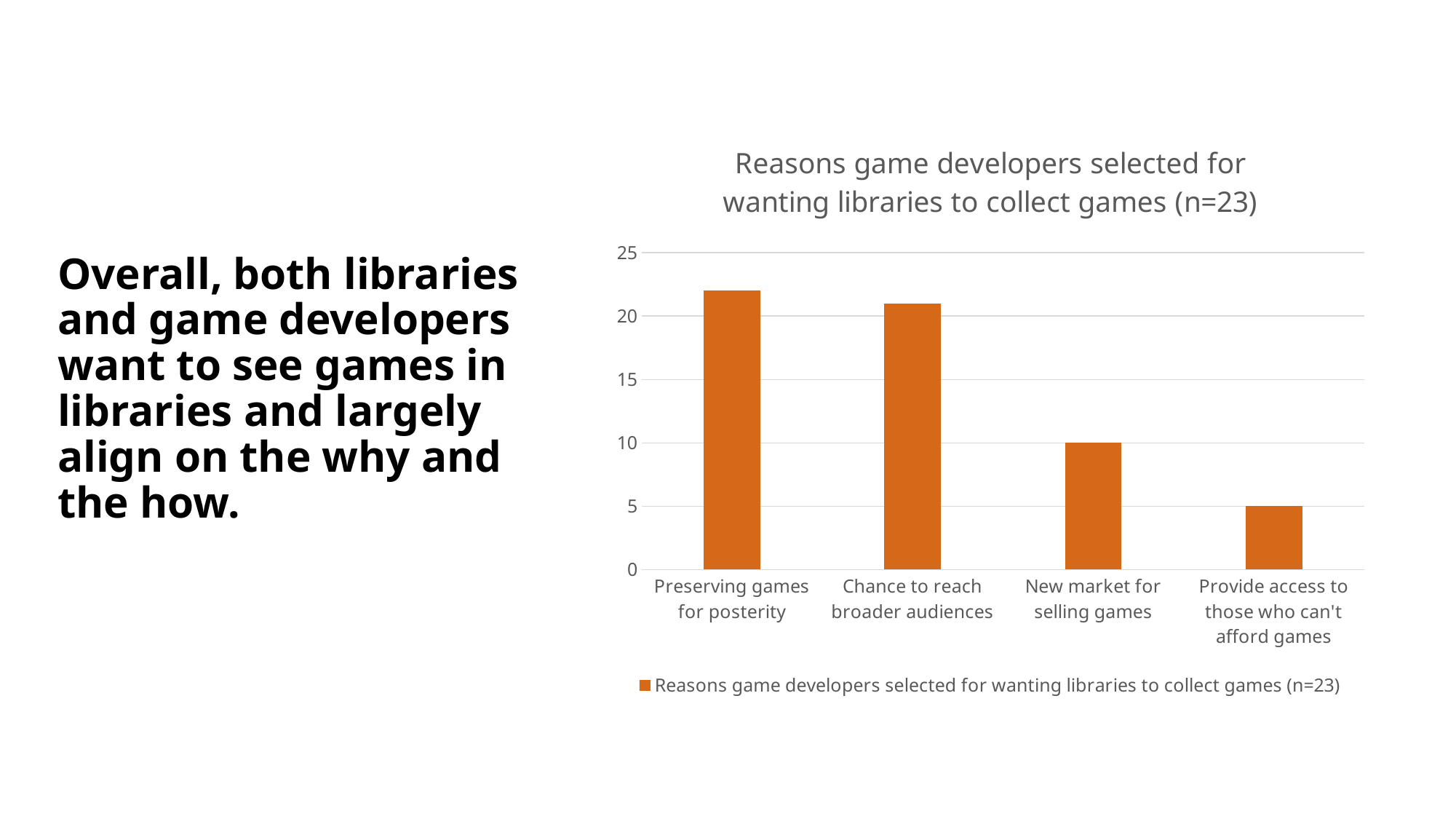
What type of chart is shown on the slide? Bar chart What is the title of the chart? Reasons game developers selected for wanting libraries to collect games (n=23) What is the value for "New market for selling games"? 10 How many series does the chart legend list? 1 Which reason has the lowest value? Provide access to those who can't afford games How many categories (reasons) are shown in the chart? 4 Do the values rise or fall moving from left to right across the categories? Fall What is the difference between the values for "New market for selling games" and "Provide access to those who can't afford games"? 5 Is the value for "Chance to reach broader audiences" greater or less than 20? greater Which reason has the highest value? Preserving games for posterity What is the value for "Provide access to those who can't afford games"? 5 Is the value for "Preserving games for posterity" greater or less than 20? greater